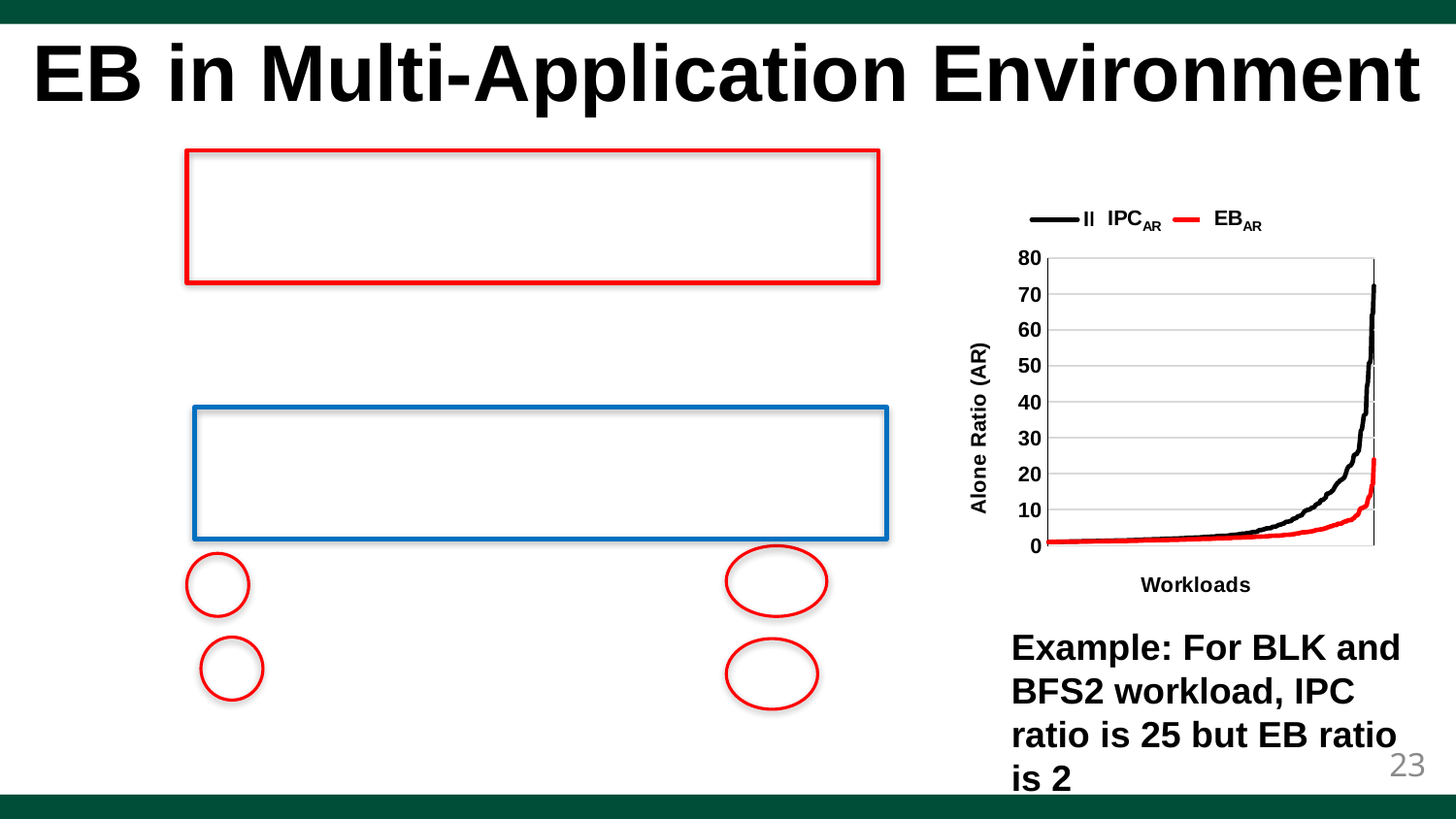
What kind of chart is shown on the slide? line chart Is the highest EB_AR value greater or less than 20? greater How many series does the chart legend list? 2 Is the highest IPC_AR value greater or less than 60? greater Do the EB_AR values rise or fall moving left to right along the x axis? rise What is the label on the horizontal axis of the chart? Workloads Do the IPC_AR values rise or fall moving left to right along the x axis? rise What is the title of the vertical axis of the chart? Alone Ratio (AR) Which series reaches the higher peak value, IPC_AR or EB_AR? IPC_AR Is the highest EB_AR value greater or less than 30? less Which series has the lower peak value, IPC_AR or EB_AR? EB_AR